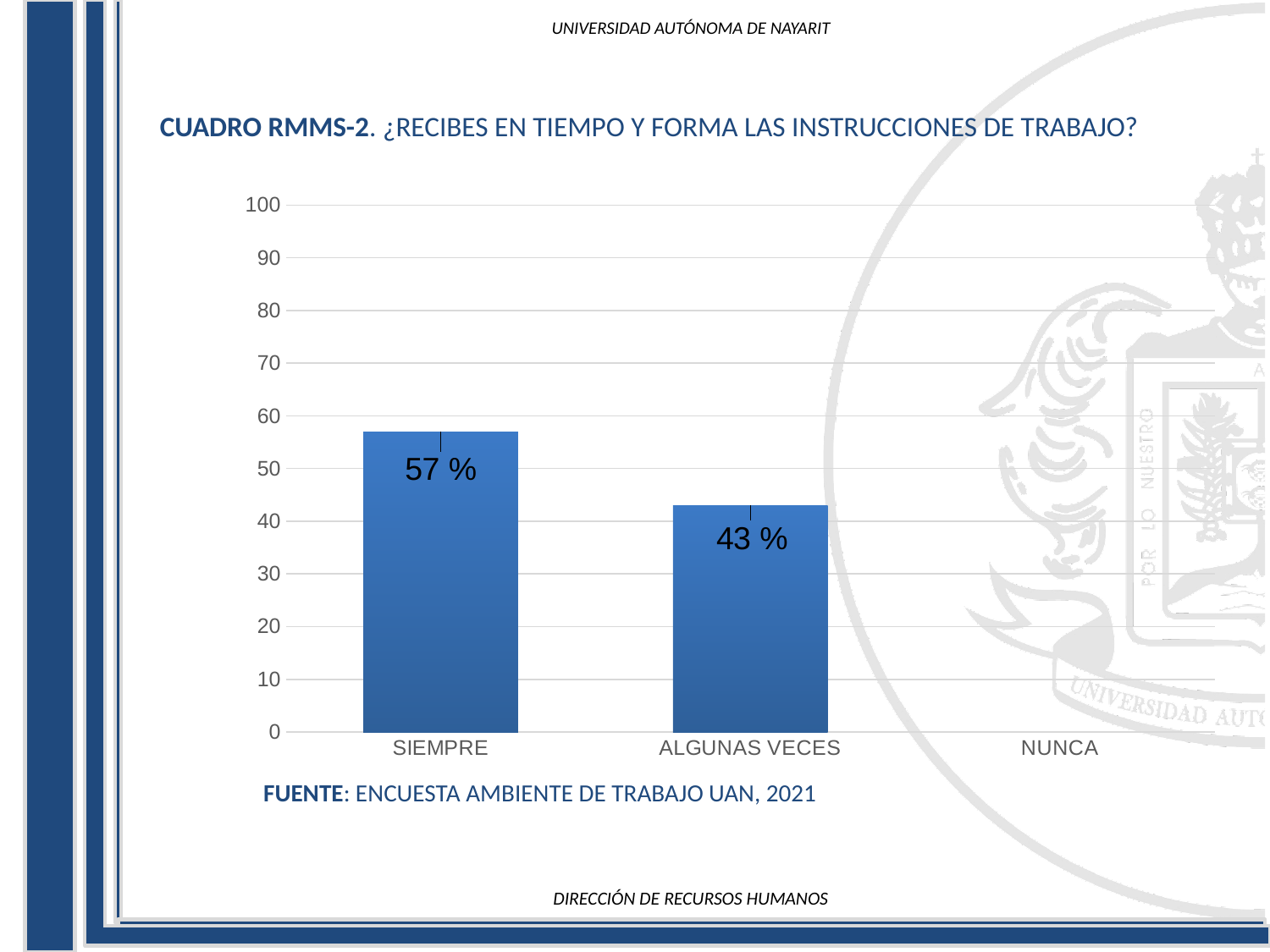
Is the value for ALGUNAS VECES greater or less than 50? less What is the difference between the values for SIEMPRE and ALGUNAS VECES? 14 % What is the value for SIEMPRE? 57 % What source is cited below the chart? ENCUESTA AMBIENTE DE TRABAJO UAN, 2021 Which is larger, the value for SIEMPRE or the value for ALGUNAS VECES? SIEMPRE Do the bar values rise or fall from SIEMPRE to ALGUNAS VECES? fall What is the value for ALGUNAS VECES? 43 % What kind of chart is shown on the slide? bar chart What is the highest value shown on the y axis? 100 Which category has the highest value? SIEMPRE Is the value for SIEMPRE greater or less than 50? greater How many categories are shown on the x axis? 3